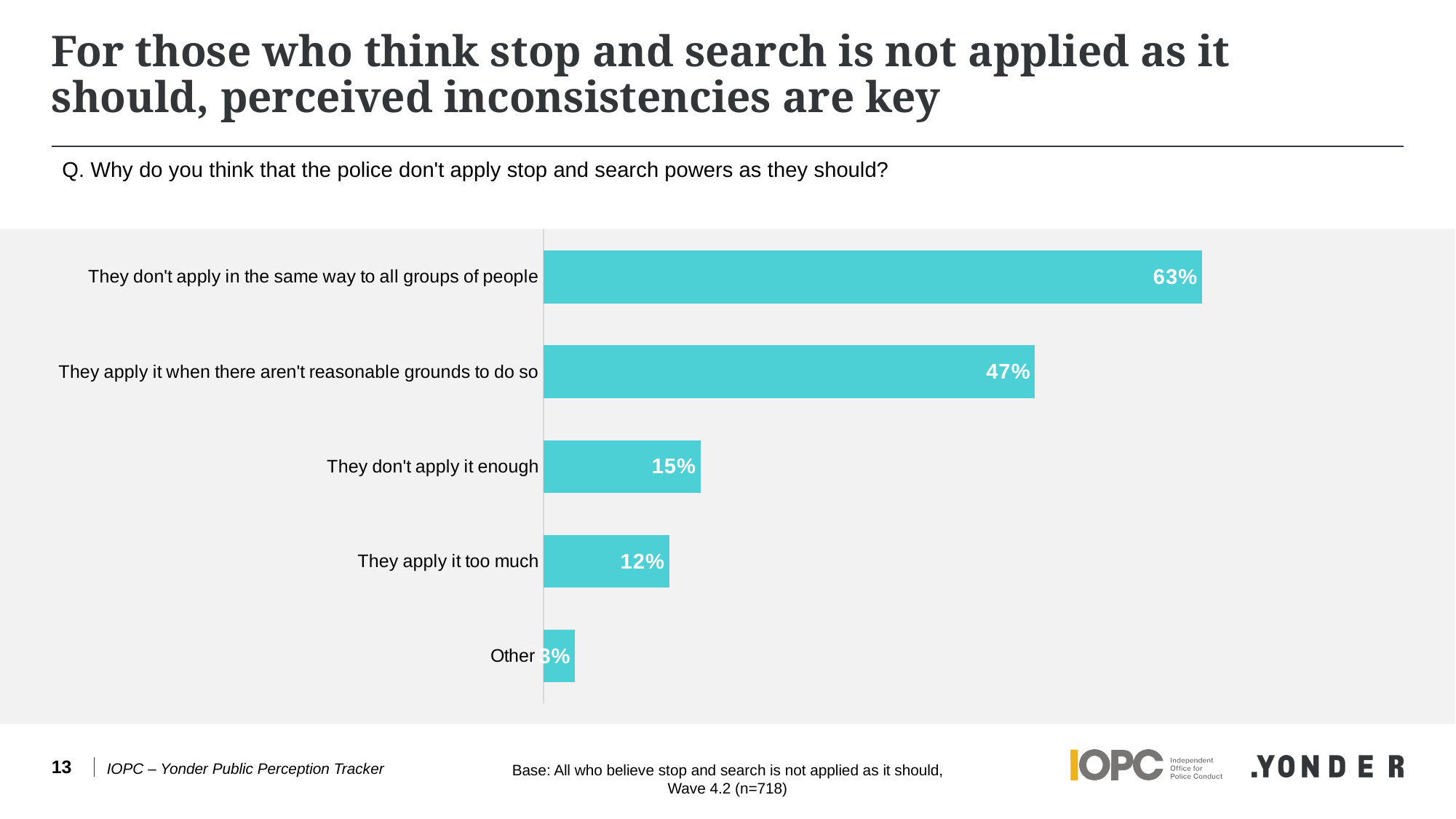
Which category has the lowest value on the chart? Other What is the value for 'They apply it when there aren't reasonable grounds to do so'? 47% What is the base size (n) stated for the chart? 718 How many categories are shown on the chart? 5 Which is larger: 'They don't apply it enough' or 'They apply it too much'? They don't apply it enough What percentage of respondents said 'They don't apply in the same way to all groups of people'? 63% Which reason has the highest percentage? They don't apply in the same way to all groups of people What is the difference between 'They don't apply in the same way to all groups of people' and 'They apply it when there aren't reasonable grounds to do so'? 16 percentage points What type of chart is shown on the slide? Bar chart What is the value shown for 'They apply it too much'? 12% What is the difference between 'They don't apply it enough' and 'They apply it too much'? 3 percentage points What percentage chose 'They don't apply it enough'? 15%